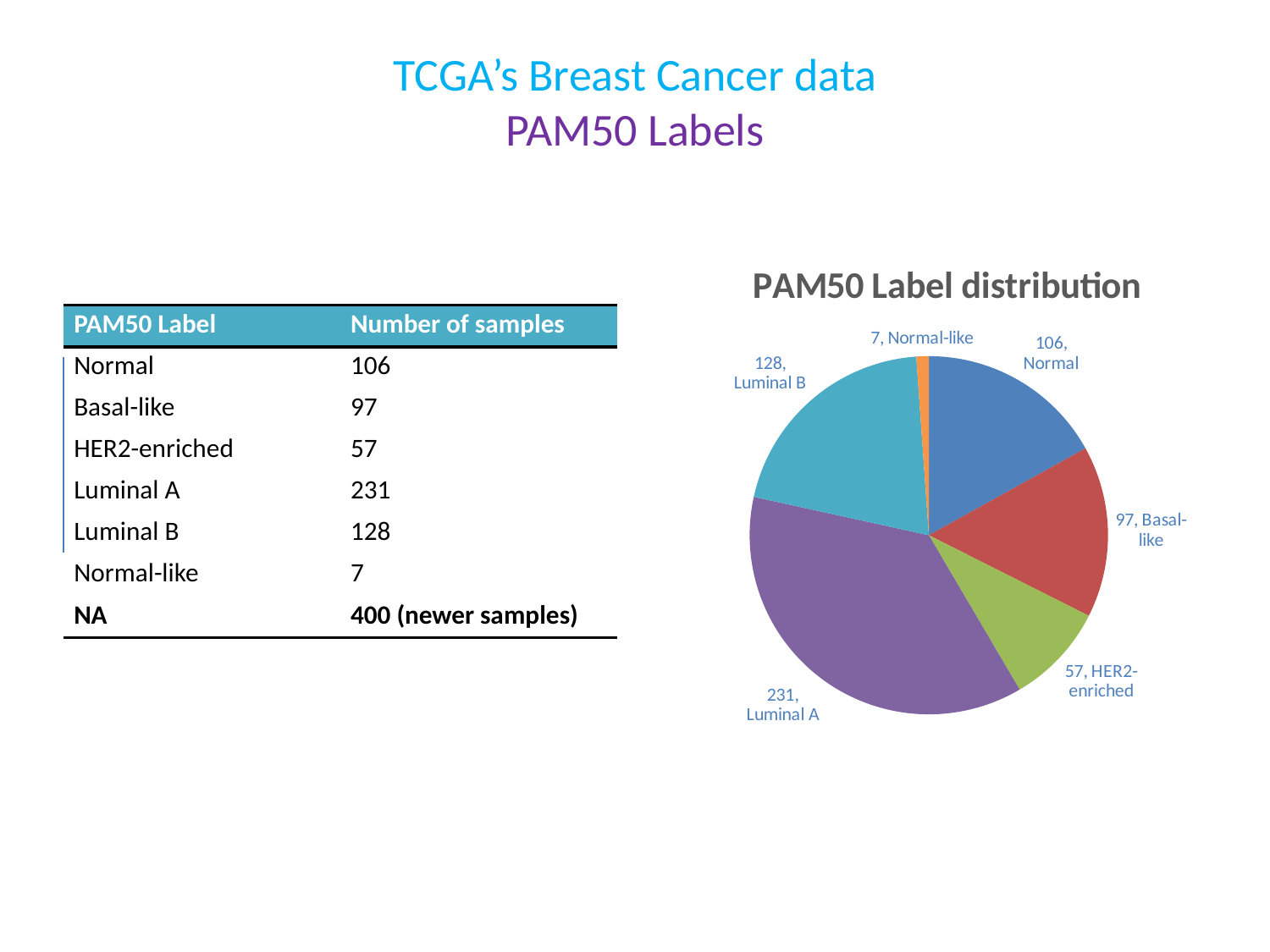
What is the value of the Luminal A slice? 231 Which PAM50 label has the largest slice in the pie chart? Luminal A Which PAM50 label has the smallest slice in the pie chart? Normal-like What share of the pie does the Luminal A slice represent? 36.9% What kind of chart is shown on the slide? pie chart What is the title of the chart? PAM50 Label distribution What is the value of the HER2-enriched slice? 57 Which is larger, the Normal slice or the Basal-like slice? Normal How many slices does the pie chart have? 6 What is the total of all the slices in the pie chart? 626 What is the difference between the Luminal A and Luminal B values? 103 What is the value of the Normal slice? 106